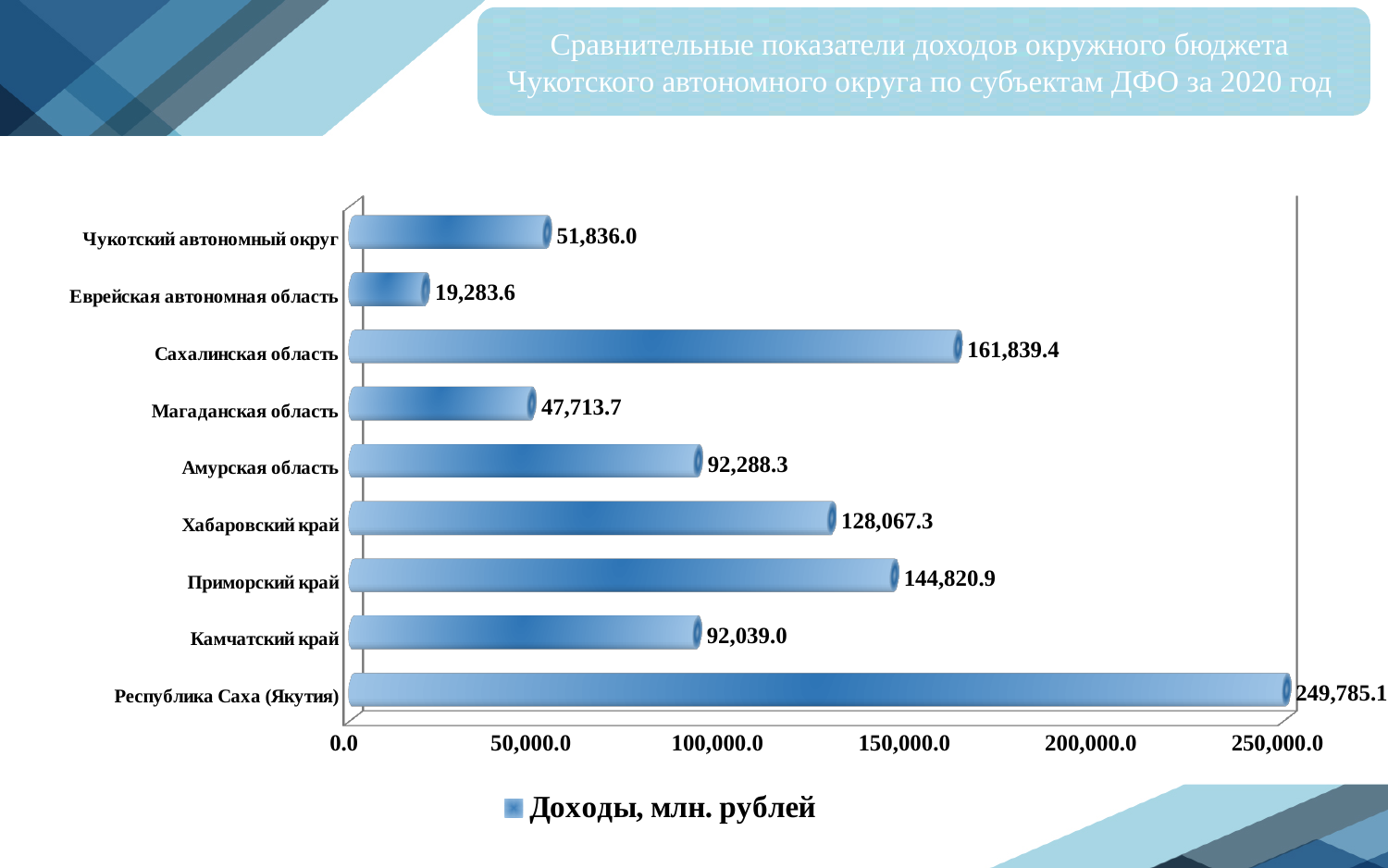
What is the value for Чукотский автономный округ? 51,836.0 What is the difference between the values for Чукотский автономный округ and Магаданская область? 4,122.3 What kind of chart is shown on the slide? bar chart Which is larger, the value for Хабаровский край or Приморский край? Приморский край Is the value for Магаданская область greater or less than 50,000.0? less What is the value for Сахалинская область? 161,839.4 What is the value for Хабаровский край? 128,067.3 What is the legend entry of the chart? Доходы, млн. рублей How many regions are shown in the chart? 9 Which region has the highest value? Республика Саха (Якутия) Which region has the lowest value? Еврейская автономная область What is the difference between the values for Сахалинская область and Приморский край? 17,018.5